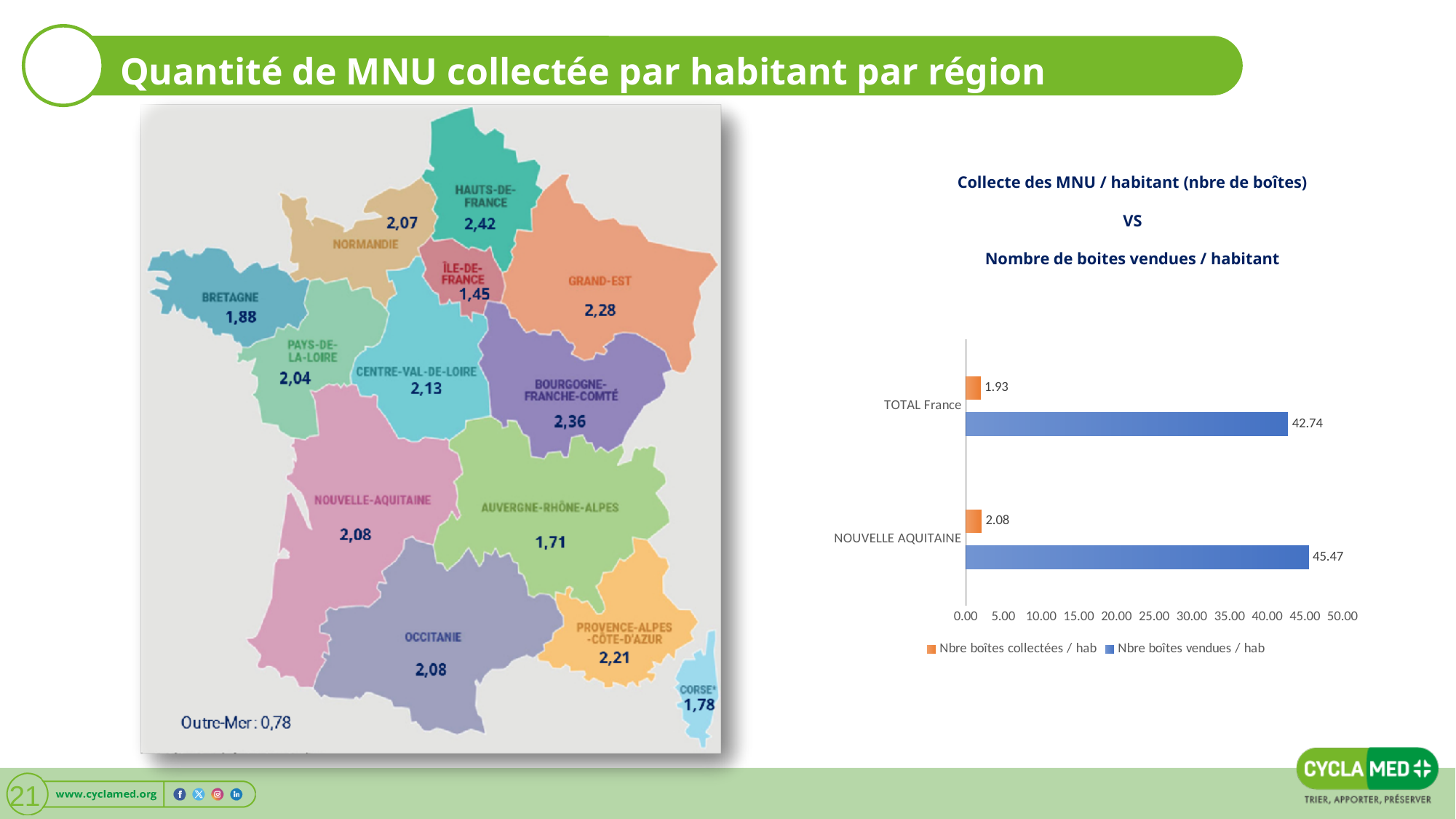
In the bar chart on the right, is the 'Nbre boîtes vendues / hab' value for TOTAL France greater or less than 40.00? greater In the bar chart on the right, which colour represents 'Nbre boîtes vendues / hab'? Blue In the bar chart on the right, what is the difference between the 'Nbre boîtes collectées / hab' values for NOUVELLE AQUITAINE and TOTAL France? 0.15 In the bar chart on the right, what is the value of 'Nbre boîtes vendues / hab' for TOTAL France? 42.74 How many series does the legend of the bar chart on the right list? 2 What kind of chart is shown on the right of the slide? Bar chart In the bar chart on the right, what is the value of 'Nbre boîtes collectées / hab' for TOTAL France? 1.93 In the bar chart on the right, what is the difference between the 'Nbre boîtes vendues / hab' values for NOUVELLE AQUITAINE and TOTAL France? 2.73 In the bar chart on the right, which has the higher 'Nbre boîtes collectées / hab' value, TOTAL France or NOUVELLE AQUITAINE? NOUVELLE AQUITAINE In the bar chart on the right, what is the value of 'Nbre boîtes collectées / hab' for NOUVELLE AQUITAINE? 2.08 How many categories are shown in the bar chart on the right? 2 In the bar chart on the right, what is the value of 'Nbre boîtes vendues / hab' for NOUVELLE AQUITAINE? 45.47